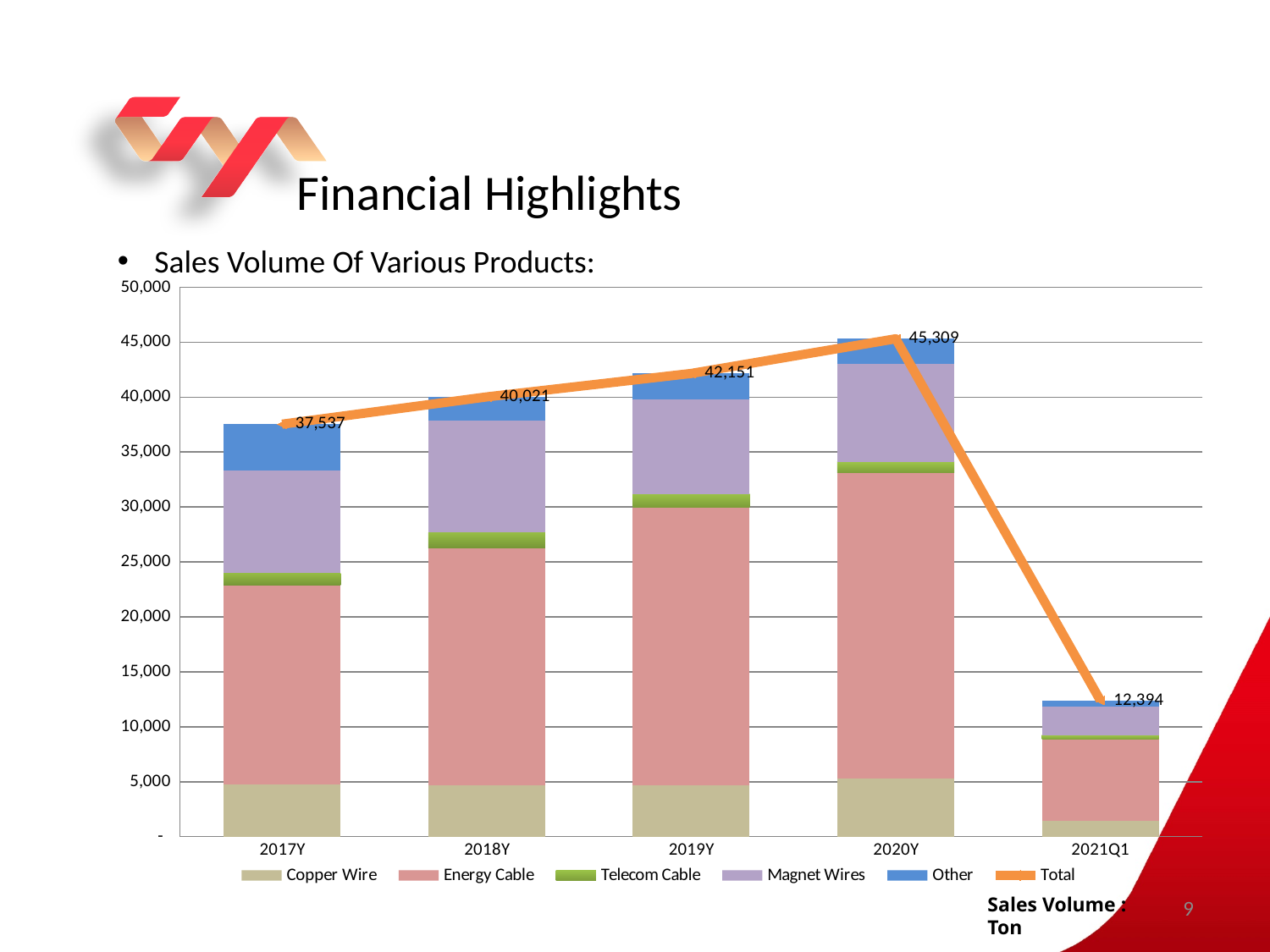
What is the total sales volume shown for 2020Y? 45,309 What is the total sales volume shown for 2017Y? 37,537 How many series does the chart legend list? 6 How many periods are shown on the x axis of the chart? 5 Does the total sales volume rise or fall from 2017Y to 2020Y? Rise What is the difference between the total sales volume in 2020Y and in 2017Y? 7,772 Which is larger, the total sales volume for 2018Y or for 2019Y? 2019Y What kind of chart is used to show the sales volume of various products? Stacked bar chart with a line for Total Is the total sales volume for 2021Q1 greater or less than 15,000? less Which period has the highest total sales volume? 2020Y Which period has the lowest total sales volume? 2021Q1 What is the total sales volume shown for 2021Q1? 12,394